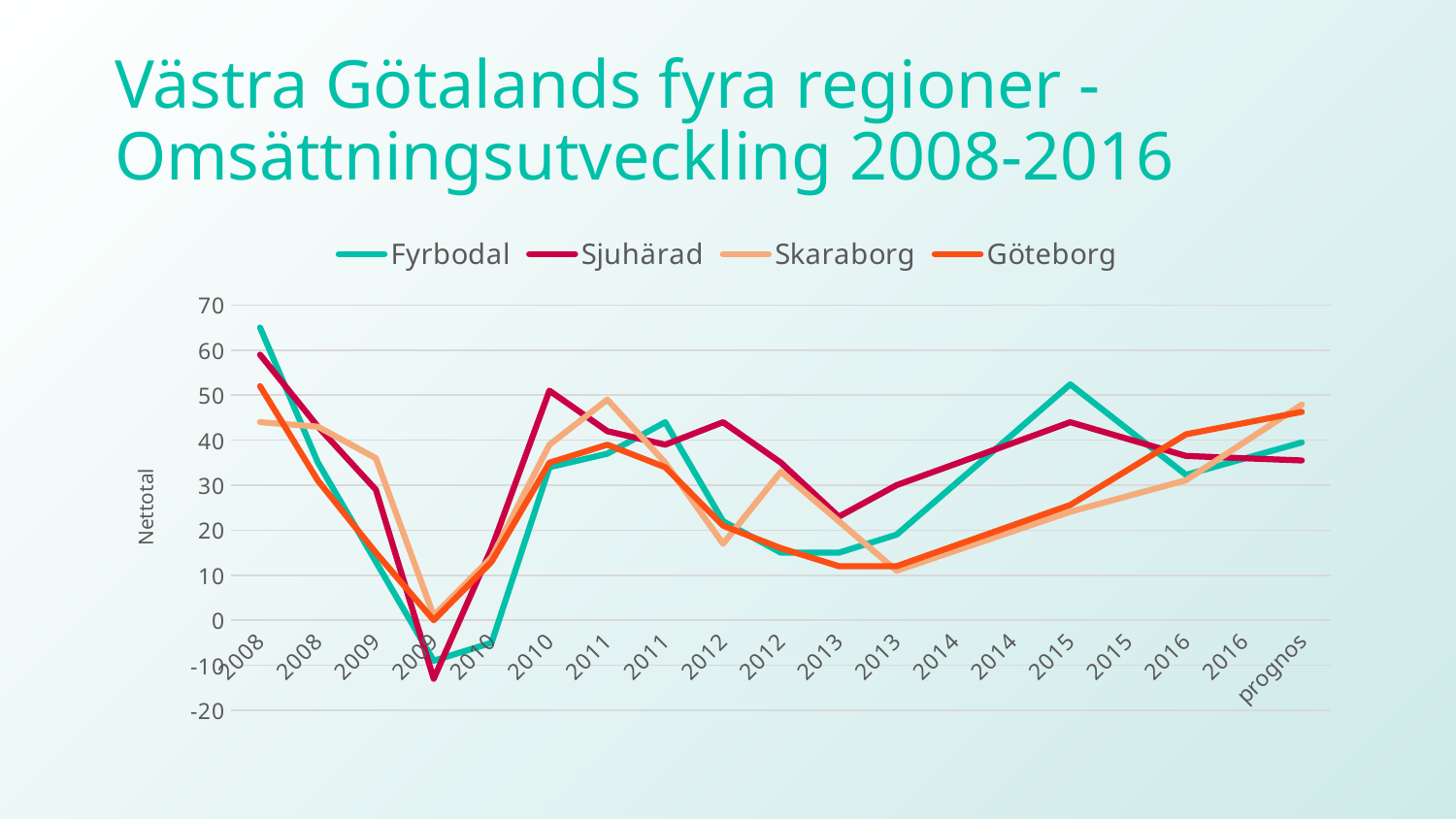
Is the value for Fyrbodal at the first 2008 point greater or less than 60? greater At the first 2015 point, which is larger: Fyrbodal or Göteborg? Fyrbodal How many series does the legend list? 4 Which series is drawn in the dark pink/magenta colour? Sjuhärad Is the value for Skaraborg at the prognos point greater or less than 40? greater What is the label of the vertical axis? Nettotal What kind of chart is shown on the slide? line chart How many points are labelled along the x axis? 19 Is the value for Sjuhärad at the second 2009 point greater or less than -10? less Which series reaches the lowest value anywhere on the chart? Sjuhärad Which series has the highest value at the first 2008 point? Fyrbodal